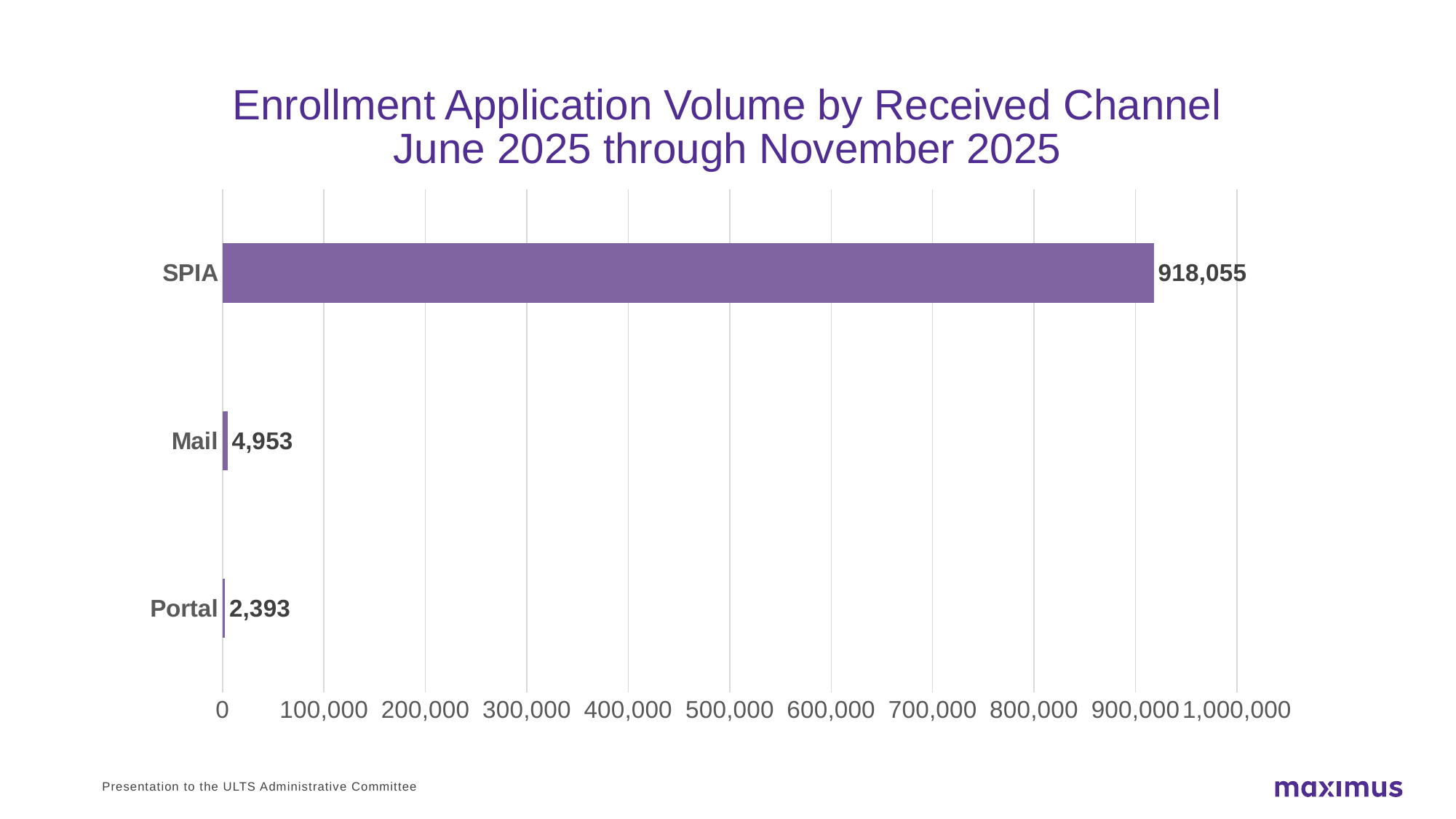
Which channel has the highest enrollment application volume? SPIA Which channel has a larger volume, Mail or Portal? Mail How many channels are shown in the chart? 3 What is the enrollment application volume for the Mail channel? 4,953 Which channel has the lowest enrollment application volume? Portal What time period does the chart title say the data covers? June 2025 through November 2025 Is the value for SPIA greater or less than 900,000? greater What is the enrollment application volume for the SPIA channel? 918,055 What is the enrollment application volume for the Portal channel? 2,393 What is the difference between the Mail and Portal volumes? 2,560 What kind of chart is shown on the slide? Bar chart What is the difference between the SPIA and Mail volumes? 913,102